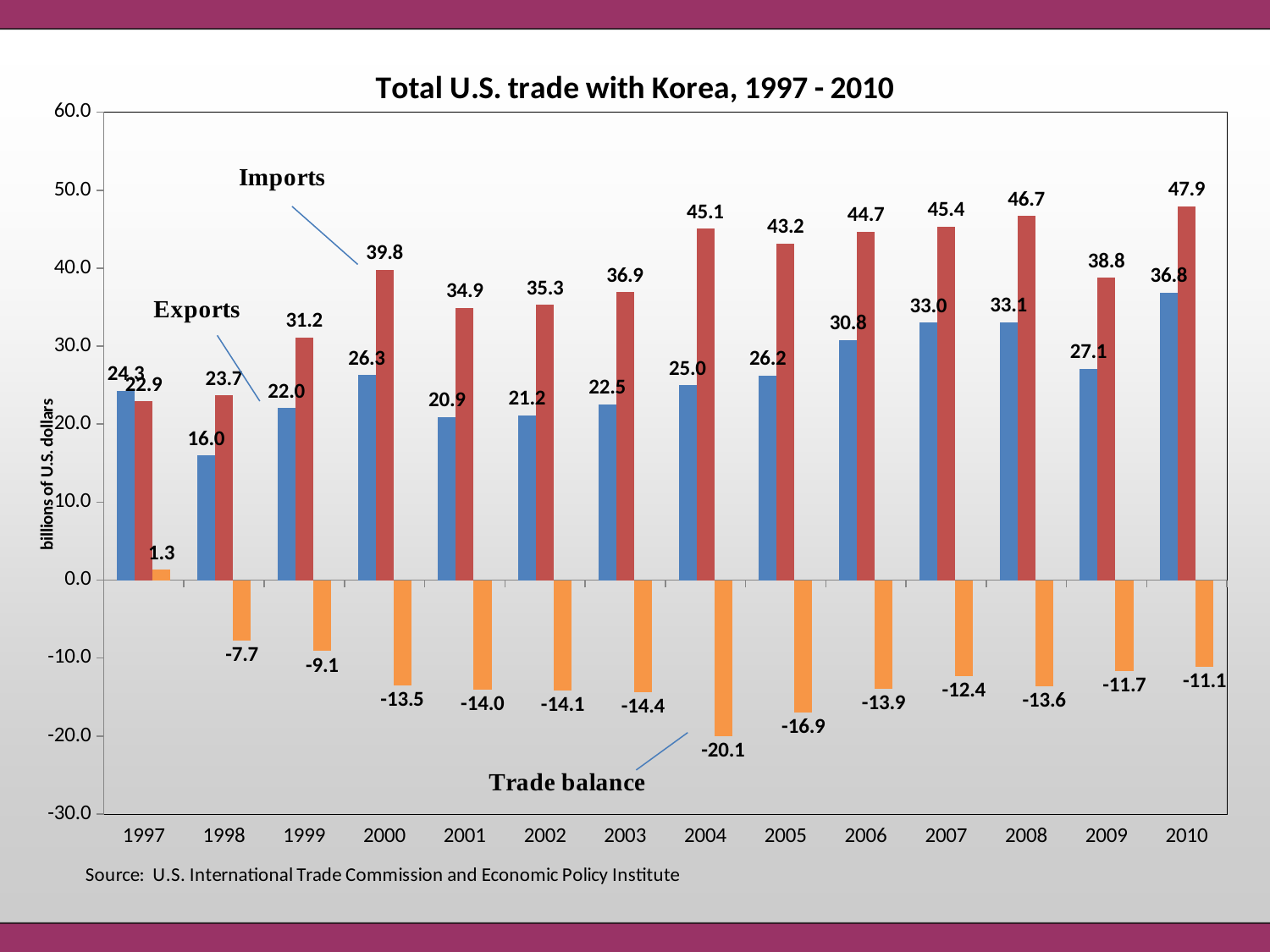
Do Exports rise or fall from 2003 to 2008? rise What is the difference between Imports and Exports in 2010? 11.1 How many years are shown on the x axis? 14 Is the value for Imports in 2003 greater or less than 30.0? greater What is the value of Imports in 2004? 45.1 What kind of chart is this? bar chart Which year has higher Exports, 2000 or 2001? 2000 What is the value of Exports in 1998? 16.0 In which year are Exports lowest? 1998 In which year are Imports highest? 2010 In which year is the Trade balance lowest (most negative)? 2004 What is the Trade balance value for 2005? -16.9